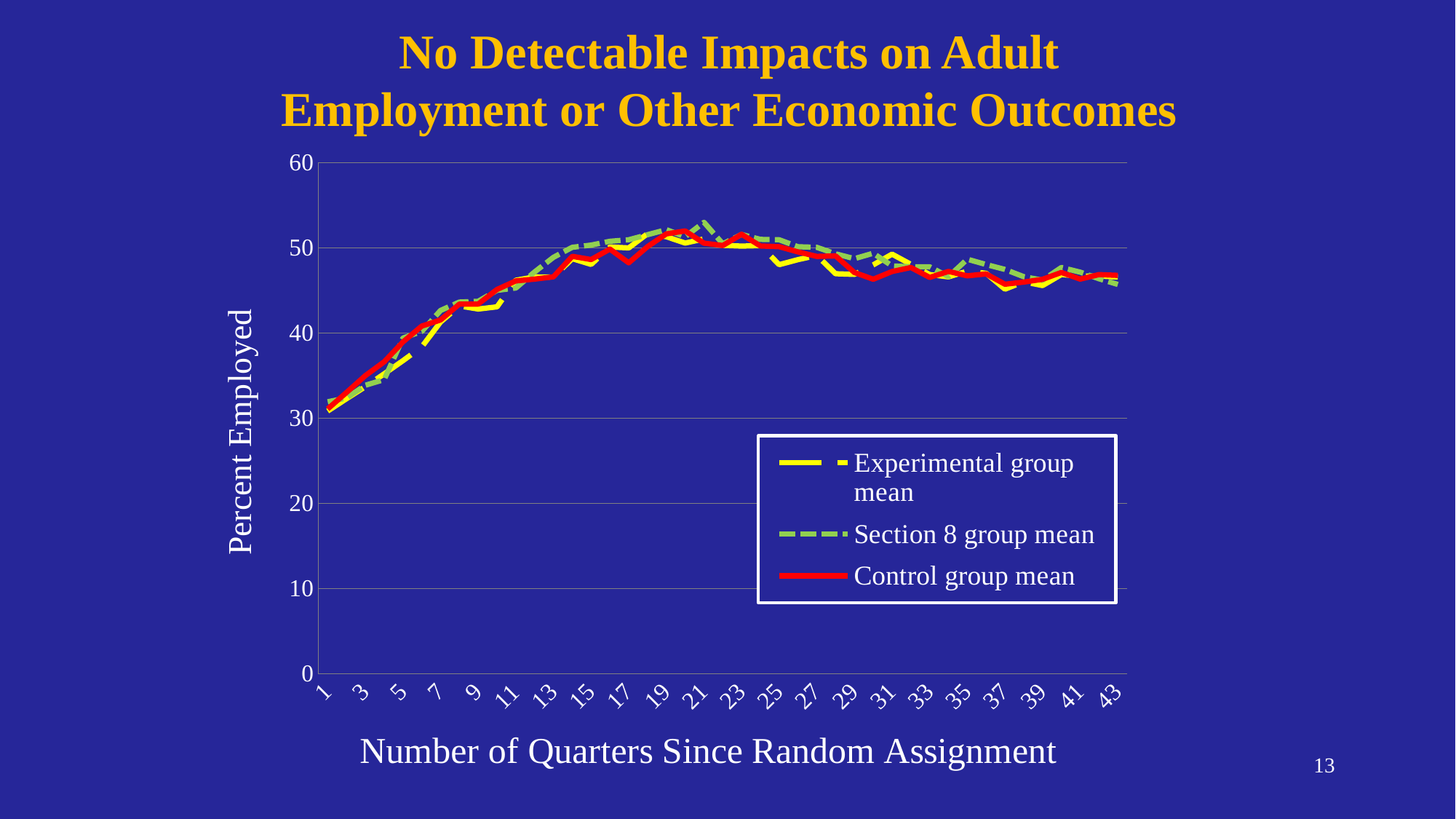
How many series does the legend list? 3 What kind of chart is shown on the slide? line chart Is the Section 8 group mean at quarter 21 greater or less than 50? greater Do the Section 8 group mean values rise or fall between quarter 21 and quarter 43? fall Is the Control group mean at quarter 9 greater or less than 40? greater What is the title of the chart on the slide? No Detectable Impacts on Adult Employment or Other Economic Outcomes What is the highest value shown on the y axis? 60 Is the Experimental group mean at quarter 43 greater or less than 50? less Do the Control group mean values rise or fall between quarter 1 and quarter 21? rise What is the label of the x axis? Number of Quarters Since Random Assignment